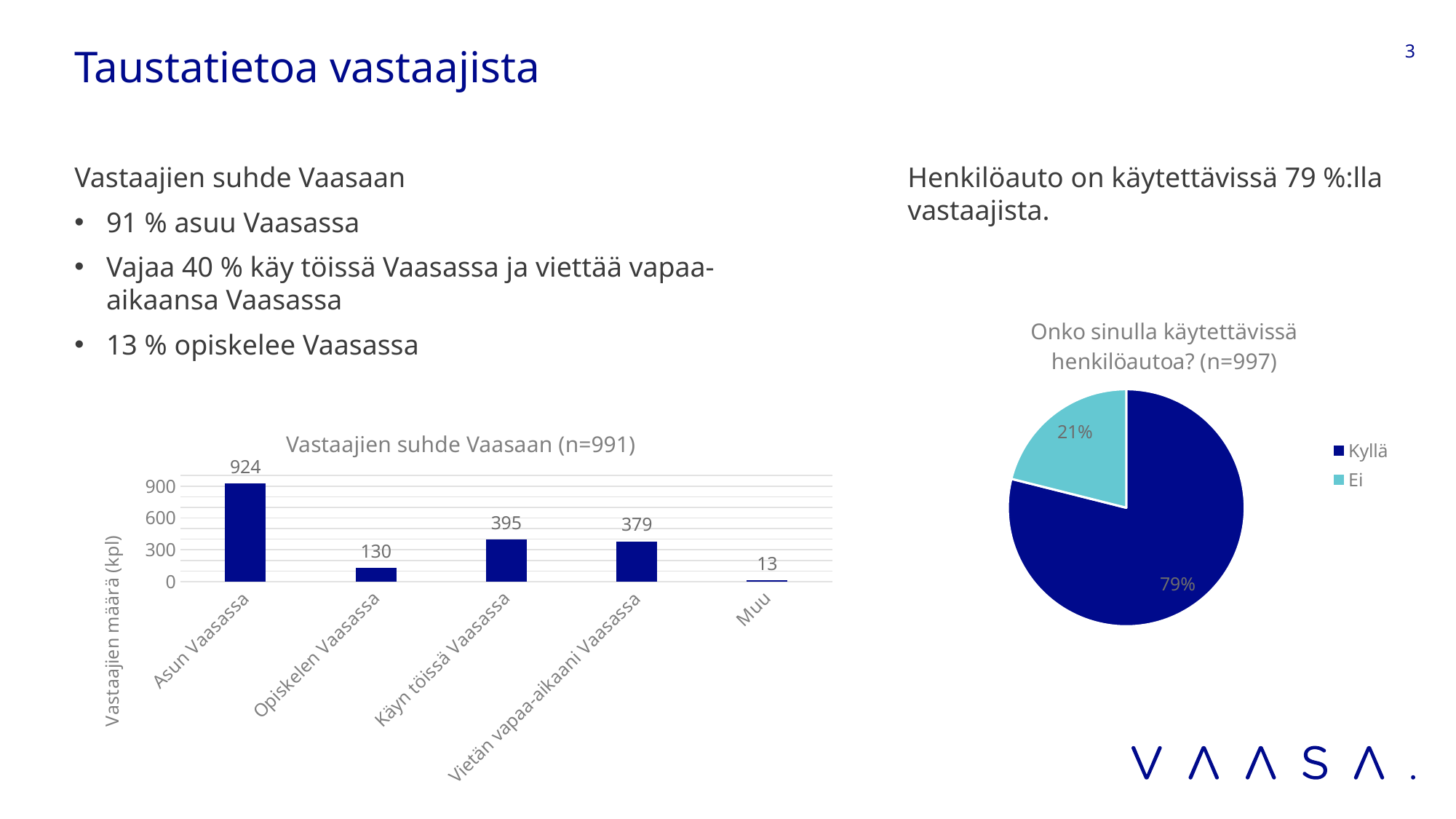
What kind of chart is 'Vastaajien suhde Vaasaan (n=991)'? bar chart In the pie chart 'Onko sinulla käytettävissä henkilöautoa? (n=997)', what share does 'Ei' have? 21% In the bar chart 'Vastaajien suhde Vaasaan (n=991)', what is the y-axis label? Vastaajien määrä (kpl) In the bar chart 'Vastaajien suhde Vaasaan (n=991)', which is larger: 'Opiskelen Vaasassa' or 'Käyn töissä Vaasassa'? Käyn töissä Vaasassa In the bar chart 'Vastaajien suhde Vaasaan (n=991)', how many categories are shown? 5 In the bar chart 'Vastaajien suhde Vaasaan (n=991)', which category has the lowest value? Muu In the bar chart 'Vastaajien suhde Vaasaan (n=991)', what is the value for 'Opiskelen Vaasassa'? 130 In the bar chart 'Vastaajien suhde Vaasaan (n=991)', what is the value for 'Asun Vaasassa'? 924 In the bar chart 'Vastaajien suhde Vaasaan (n=991)', what is the value for 'Muu'? 13 In the bar chart 'Vastaajien suhde Vaasaan (n=991)', what is the difference between 'Käyn töissä Vaasassa' and 'Vietän vapaa-aikaani Vaasassa'? 16 In the bar chart 'Vastaajien suhde Vaasaan (n=991)', which category has the highest value? Asun Vaasassa In the pie chart 'Onko sinulla käytettävissä henkilöautoa? (n=997)', what share does 'Kyllä' have? 79%